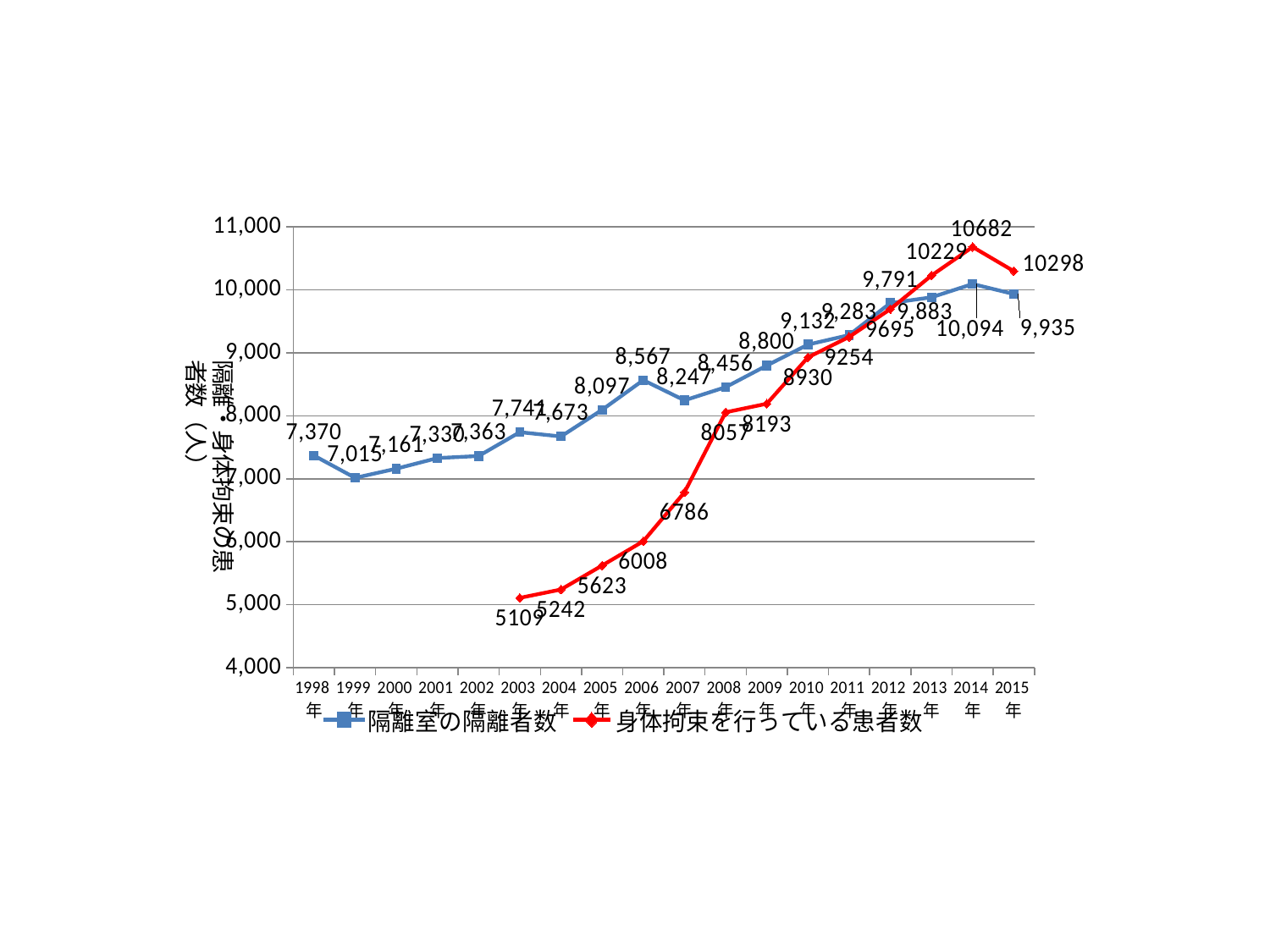
What is the value of 隔離室の隔離者数 in 2014年? 10,094 What is the difference between 隔離室の隔離者数 in 2014年 and 2015年? 159 How many years are shown on the x axis? 18 In which year does 身体拘束を行っている患者数 reach its highest value? 2014年 What type of chart is shown on the slide? line chart What is the value of 身体拘束を行っている患者数 in 2003年? 5109 Which series has the larger value in 2013年, 隔離室の隔離者数 or 身体拘束を行っている患者数? 身体拘束を行っている患者数 How many series does the legend list? 2 In which year is 隔離室の隔離者数 at its lowest? 1999年 What is the value of 身体拘束を行っている患者数 in 2015年? 10298 What is the value of 隔離室の隔離者数 in 1998年? 7,370 Does 身体拘束を行っている患者数 generally rise or fall from 2003年 to 2014年? rise